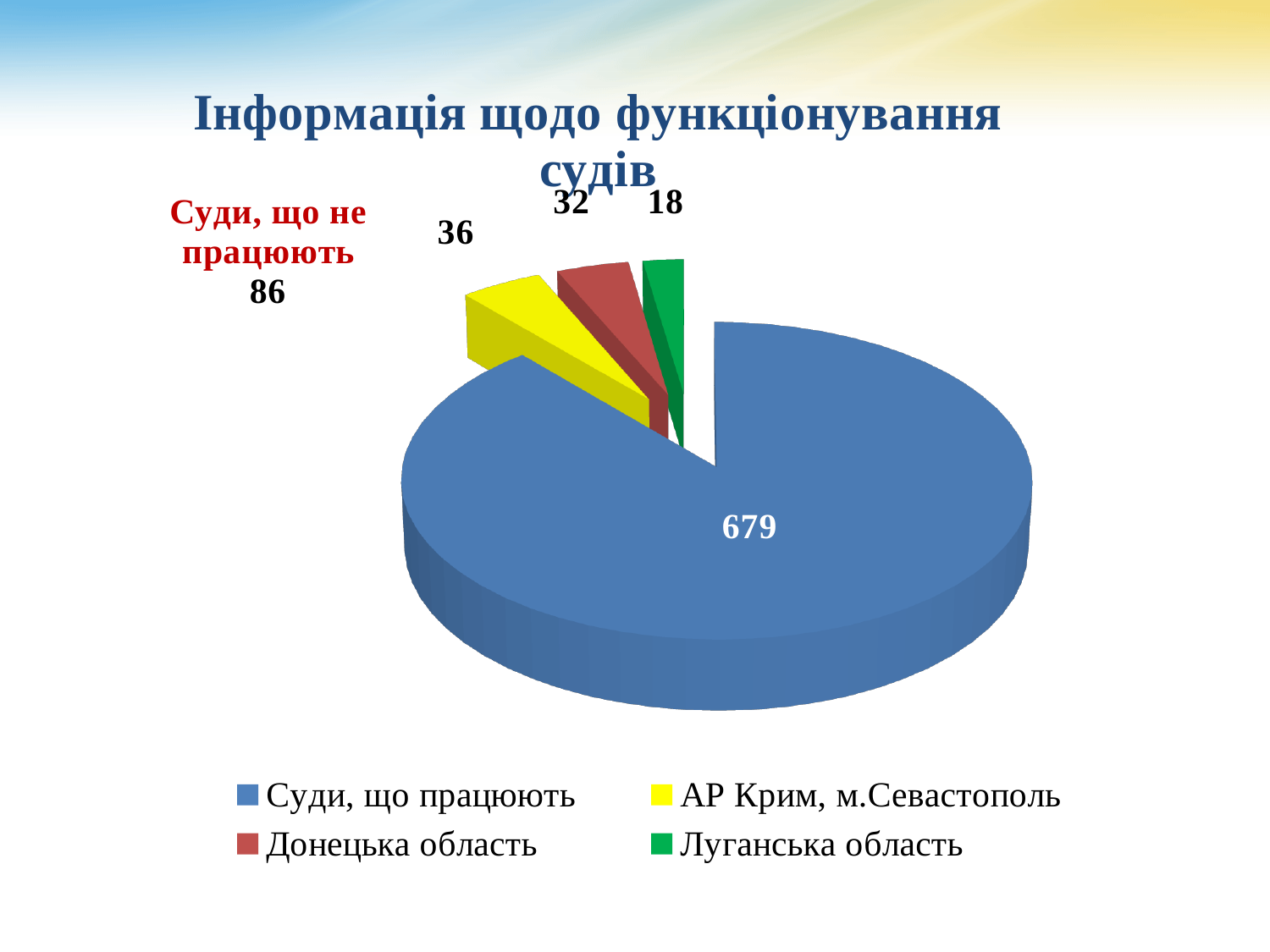
What is the value for Донецька область? 32 How many categories does the legend list? 4 What is the value for АР Крим, м.Севастополь? 36 Which category has the largest slice of the pie? Суди, що працюють What is the value for Суди, що працюють? 679 What type of chart is shown on the slide? Pie chart What is the title of the chart? Інформація щодо функціонування судів What is the difference between the values for АР Крим, м.Севастополь and Луганська область? 18 What is the value for Луганська область? 18 Which is larger, the value for Донецька область or the value for Луганська область? Донецька область Which category has the smallest slice of the pie? Луганська область What number is shown next to the label 'Суди, що не працюють'? 86